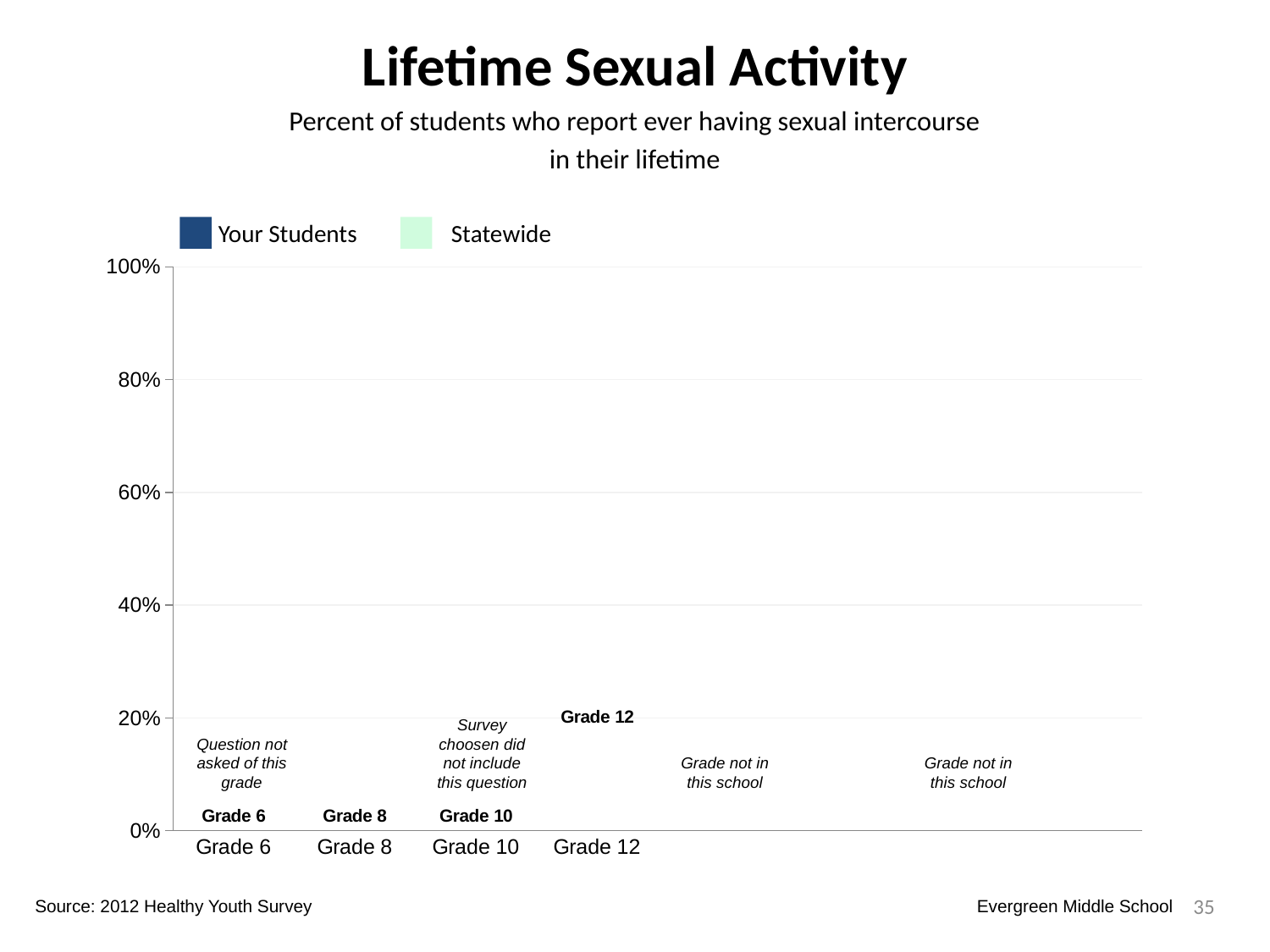
What note is shown for Grade 10 in the chart? Survey choosen did not include this question What note is shown for Grade 6 in the chart? Question not asked of this grade How many series does the legend list? 2 What are the two series named in the legend? Your Students and Statewide What is the highest value shown on the y axis? 100% What is the title of the chart? Lifetime Sexual Activity How many grade categories are shown on the x axis? 4